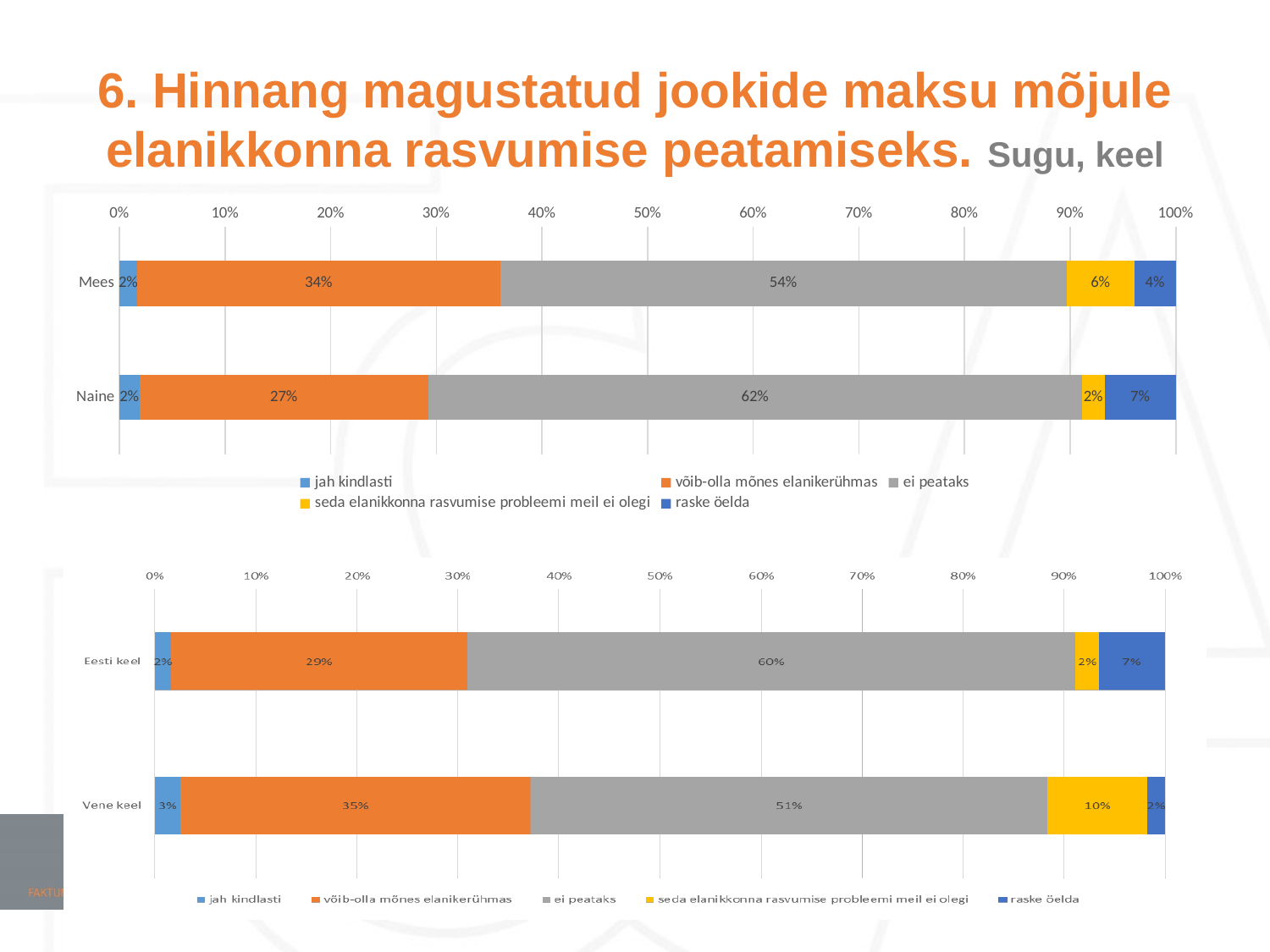
What type of chart is the top chart (by gender)? Stacked bar chart In the bottom chart (by language), what percentage of Eesti keel respondents answered 'ei peataks'? 60% In the top chart (by gender), what percentage of Naine answered 'võib-olla mõnes elanikerühmas'? 27% How many series does the legend of the top chart (by gender) list? 5 In the top chart (by gender), what is the difference between the 'võib-olla mõnes elanikerühmas' shares of Mees and Naine? 7% In the bottom chart (by language), what is the difference between the 'ei peataks' shares of Eesti keel and Vene keel? 9% In the top chart (by gender), what percentage of Mees answered 'ei peataks'? 54% In the bottom chart (by language), which group has the larger 'võib-olla mõnes elanikerühmas' share, Eesti keel or Vene keel? Vene keel In the top chart (by gender), what percentage of Naine answered 'raske öelda'? 7% In the top chart (by gender), which group has the larger 'ei peataks' share, Mees or Naine? Naine In the bottom chart (by language), what percentage of Vene keel respondents answered 'seda elanikkonna rasvumise probleemi meil ei olegi'? 10% How many categories are shown in the bottom chart (by language)? 2